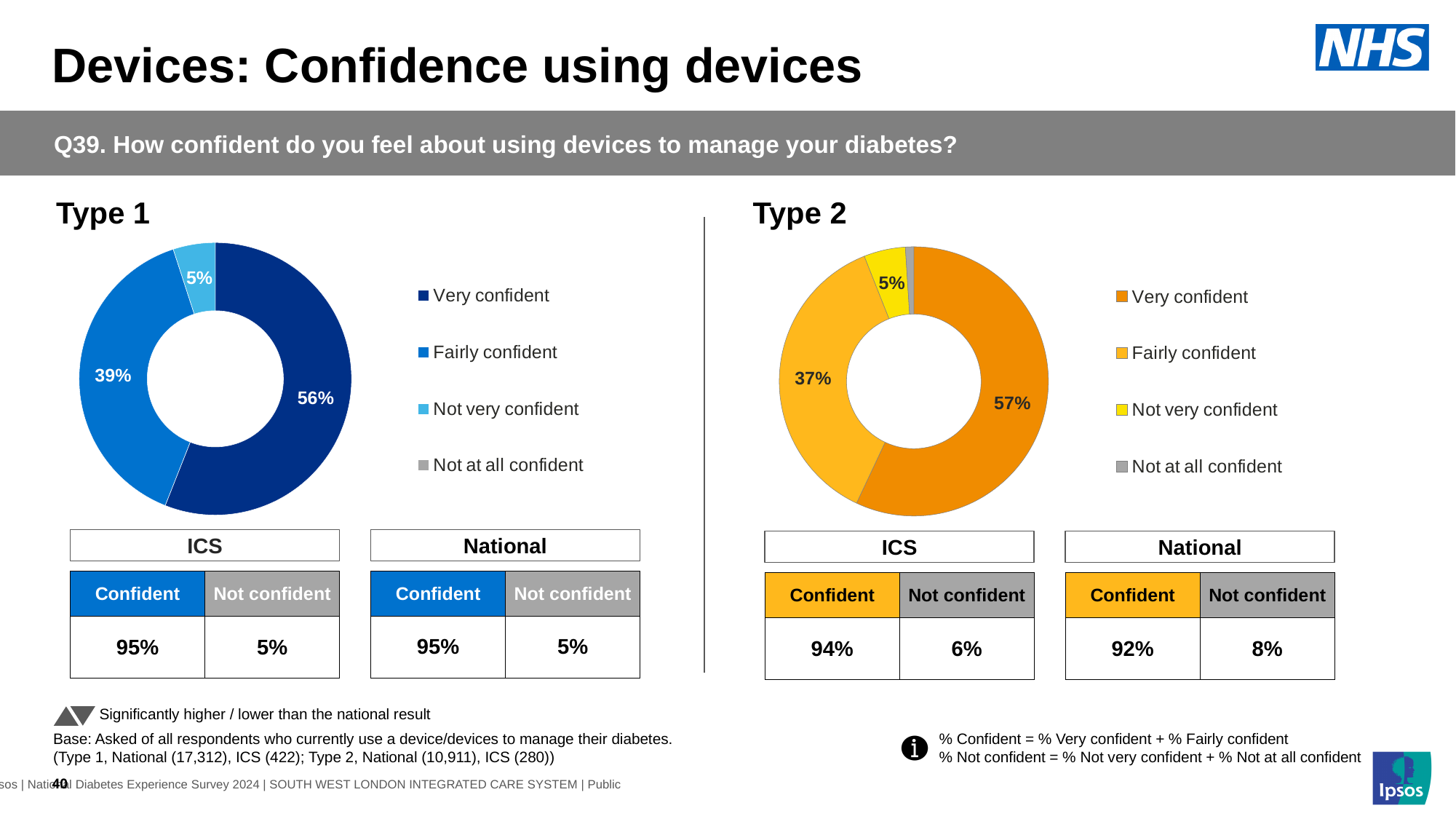
In the Type 2 chart, what percentage of respondents are very confident? 57% In the Type 1 chart, what percentage of respondents are very confident? 56% In the Type 2 chart, what colour represents the 'Very confident' category? Orange In the Type 2 chart, what percentage of respondents are fairly confident? 37% In the Type 2 chart, which is larger: the share for very confident or for fairly confident? Very confident How many categories does the legend of the Type 2 chart list? 4 In the Type 2 chart, what percentage of respondents are not very confident? 5% In the Type 1 chart, what percentage of respondents are fairly confident? 39% In the Type 2 chart, which category has the smallest share? Not at all confident In the Type 1 chart, which category has the largest share? Very confident In the Type 1 chart, what is the difference in percentage points between very confident and fairly confident? 17 percentage points What kind of chart is used for Type 1? Pie chart (donut)